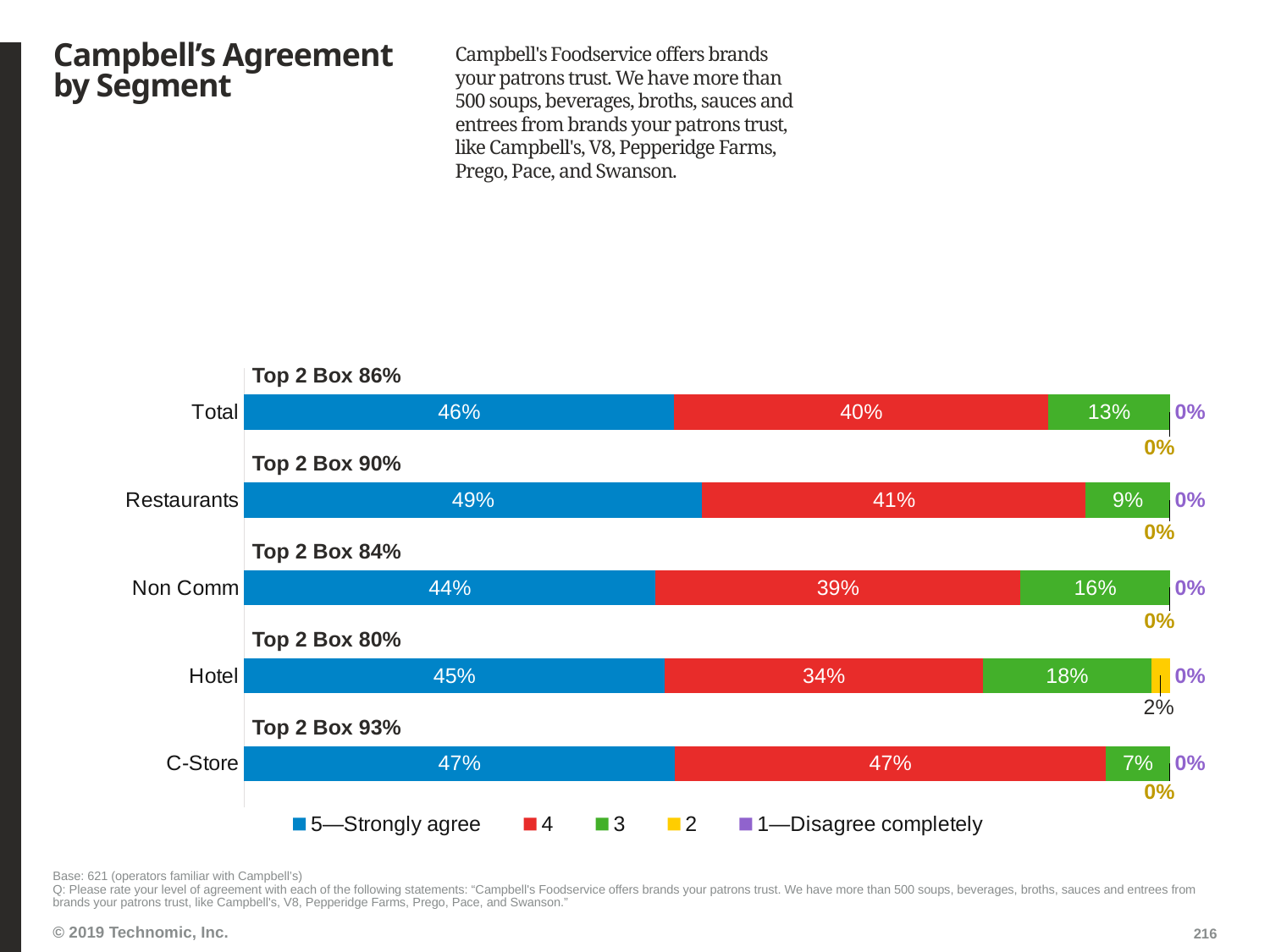
What is the difference between the rating-4 percentages for C-Store and Hotel? 13% What percentage of Restaurants respondents answered "5—Strongly agree"? 49% How many series does the legend list? 5 Which segment has the highest "5—Strongly agree" percentage? Restaurants What is the Top 2 Box value for C-Store? 93% How many segments are shown on the chart? 5 Which segment has a non-zero percentage for rating 2? Hotel What percentage of Hotel respondents gave a rating of 3? 18% What kind of chart is shown on the slide? Stacked bar chart What is the Top 2 Box value for Non Comm? 84% Which is larger: the "5—Strongly agree" percentage for Non Comm or for Hotel? Hotel Which segment has the lowest percentage for rating 3? C-Store